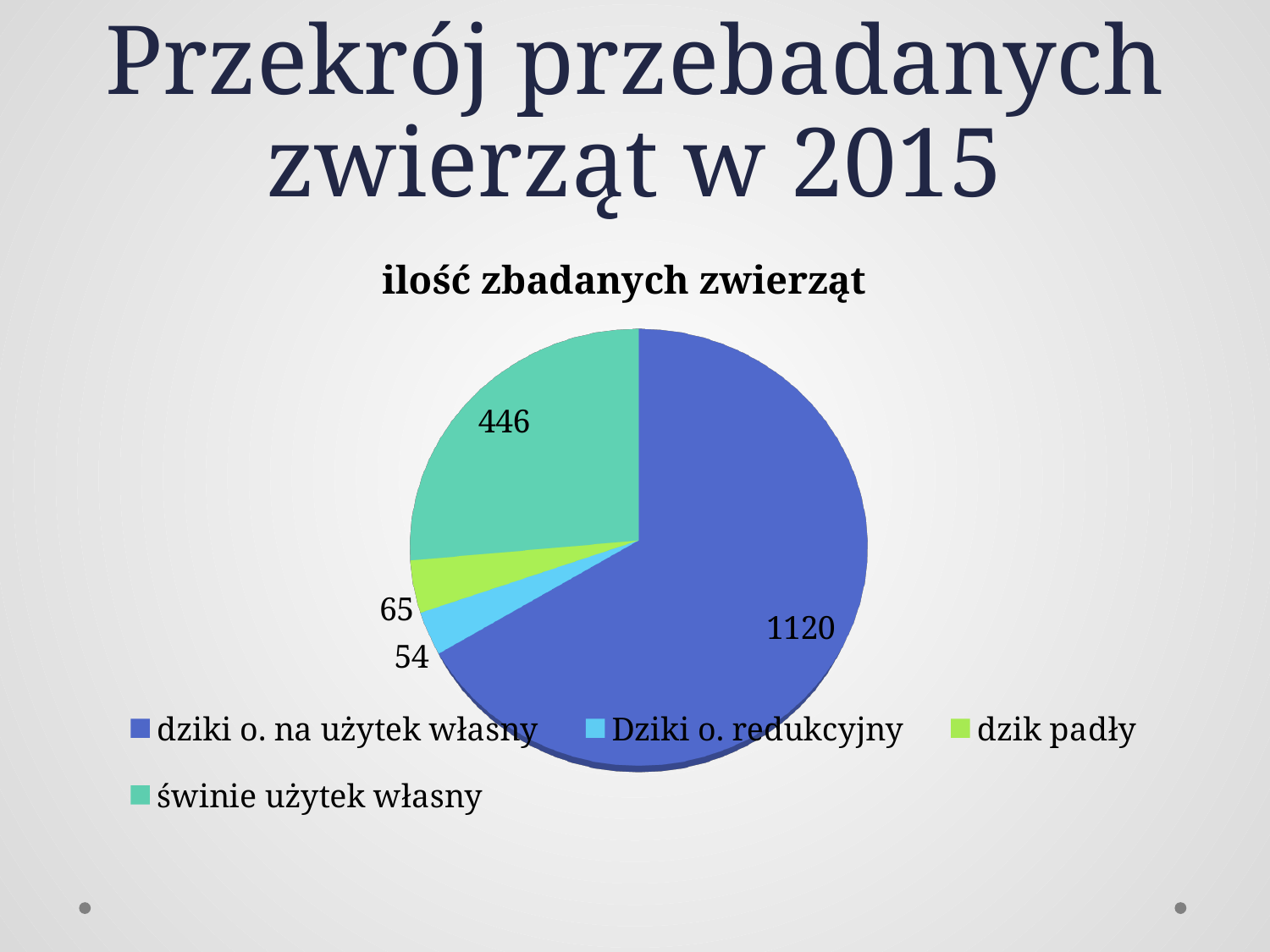
What is the value for 'świnie użytek własny'? 446 Which is larger, the value for 'dzik padły' or the value for 'Dziki o. redukcyjny'? dzik padły What is the total of all the values shown in the pie chart? 1685 What is the value for 'dziki o. na użytek własny'? 1120 What is the difference between the values for 'dziki o. na użytek własny' and 'świnie użytek własny'? 674 What is the title of the chart? ilość zbadanych zwierząt Which category has the smallest slice of the pie? Dziki o. redukcyjny What is the value for 'Dziki o. redukcyjny'? 54 What type of chart is shown on the slide? pie chart Which category has the largest slice of the pie? dziki o. na użytek własny What is the value for 'dzik padły'? 65 How many slices does the pie chart have? 4